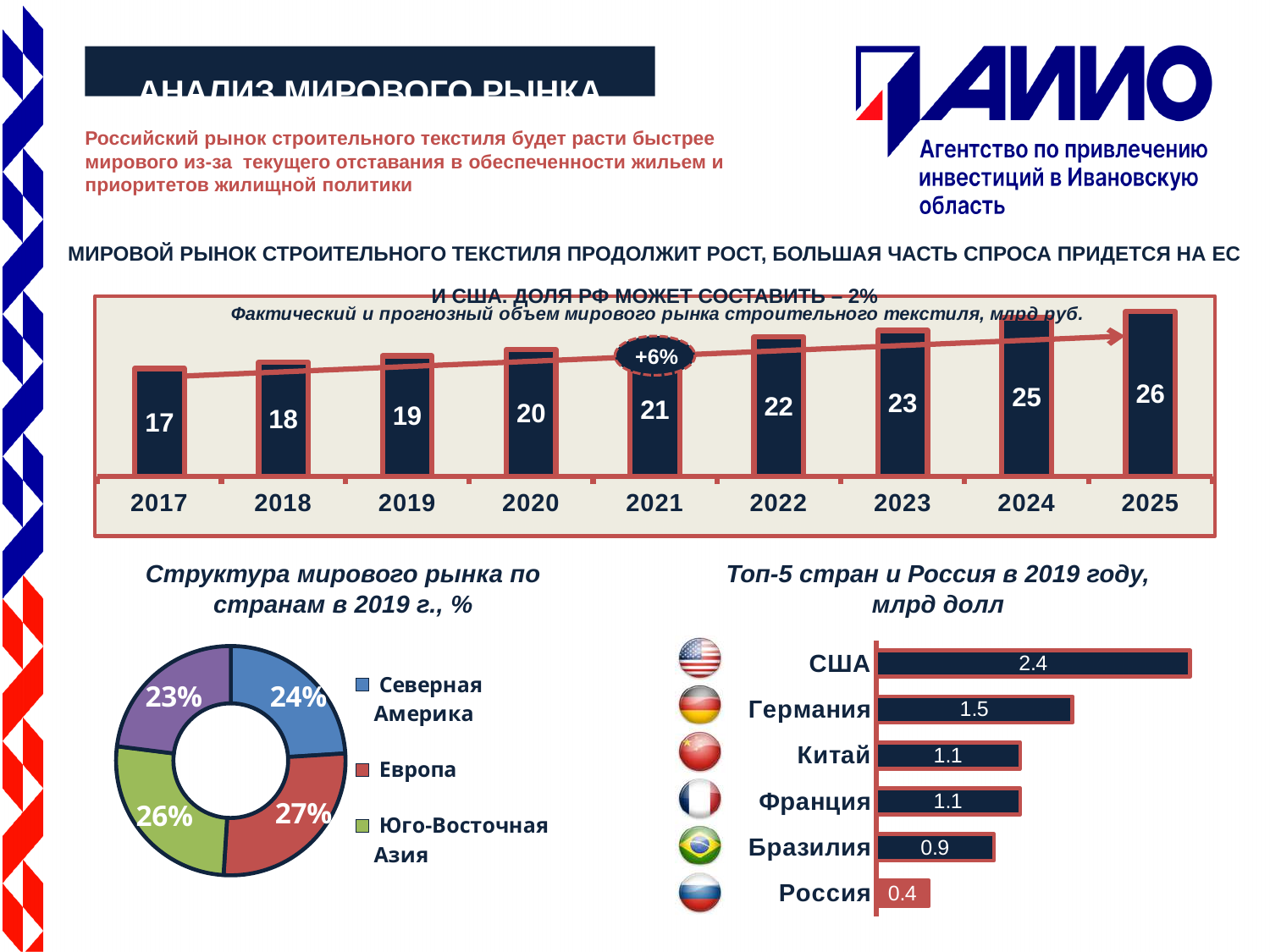
In the chart 'Структура мирового рынка по странам в 2019 г., %', what share does Северная Америка have? 24% In the top chart 'Фактический и прогнозный объем мирового рынка строительного текстиля, млрд руб.', which year has the highest value? 2025 In the chart 'Топ-5 стран и Россия в 2019 году, млрд долл', which country has the lowest value? Россия In the chart 'Топ-5 стран и Россия в 2019 году, млрд долл', which is larger, the value for Бразилия or the value for Китай? Китай In the top chart 'Фактический и прогнозный объем мирового рынка строительного текстиля, млрд руб.', what is the difference between the values for 2025 and 2017? 9 In the top chart 'Фактический и прогнозный объем мирового рынка строительного текстиля, млрд руб.', what is the value for 2021? 21 In the chart 'Структура мирового рынка по странам в 2019 г., %', what share does Европа have? 27% In the top chart 'Фактический и прогнозный объем мирового рынка строительного текстиля, млрд руб.', do the values rise or fall from 2017 to 2025? rise What type of chart is 'Структура мирового рынка по странам в 2019 г., %'? doughnut chart In the chart 'Топ-5 стран и Россия в 2019 году, млрд долл', what is the difference between the values for США and Россия? 2.0 In the top chart 'Фактический и прогнозный объем мирового рынка строительного текстиля, млрд руб.', how many years are shown on the x axis? 9 In the chart 'Топ-5 стран и Россия в 2019 году, млрд долл', what is the value for Германия? 1.5